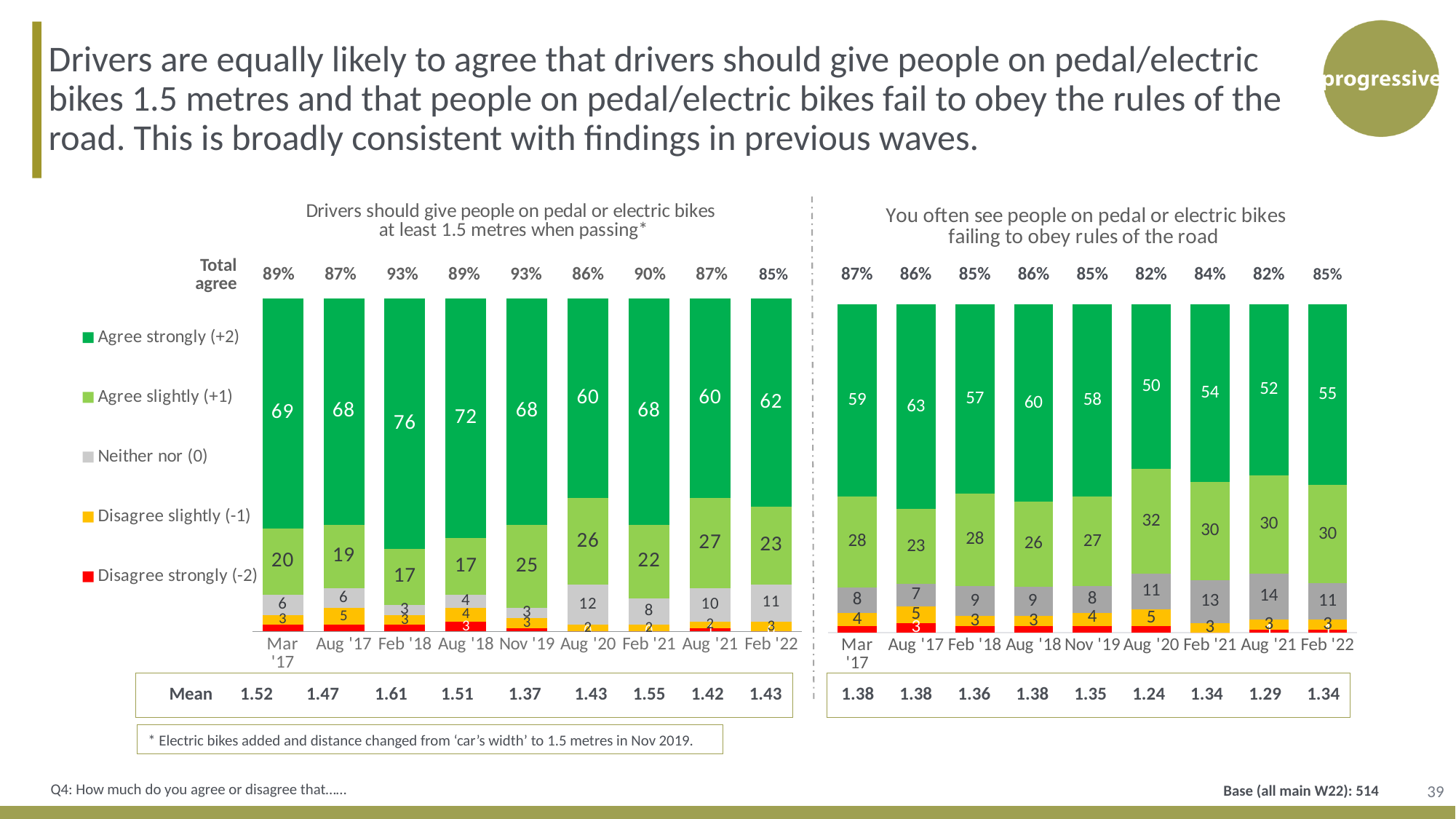
In the left chart (Drivers should give people on pedal or electric bikes at least 1.5 metres when passing), what is the Total agree percentage for Feb '22? 85% In the right chart (You often see people on pedal or electric bikes failing to obey rules of the road), what is the Total agree percentage for Aug '21? 82% What kind of chart is used on this slide? Stacked bar chart In the left chart (Drivers should give people on pedal or electric bikes at least 1.5 metres when passing), which wave has the highest Agree strongly value? Feb '18 In the right chart (You often see people on pedal or electric bikes failing to obey rules of the road), which wave has the lowest Agree strongly value? Aug '20 In the left chart (Drivers should give people on pedal or electric bikes at least 1.5 metres when passing), what is the Agree strongly value for Feb '18? 76 In the right chart (You often see people on pedal or electric bikes failing to obey rules of the road), what is the Agree slightly value for Aug '20? 32 How many waves (bars) are shown in the left chart (Drivers should give people on pedal or electric bikes at least 1.5 metres when passing)? 9 In the left chart (Drivers should give people on pedal or electric bikes at least 1.5 metres when passing), what is the difference between the Agree strongly values for Feb '18 and Feb '22? 14 In the right chart (You often see people on pedal or electric bikes failing to obey rules of the road), is the Neither nor value larger for Aug '21 or for Mar '17? Aug '21 In the right chart (You often see people on pedal or electric bikes failing to obey rules of the road), what is the Mean value for Aug '20? 1.24 How many series does the legend list? 5